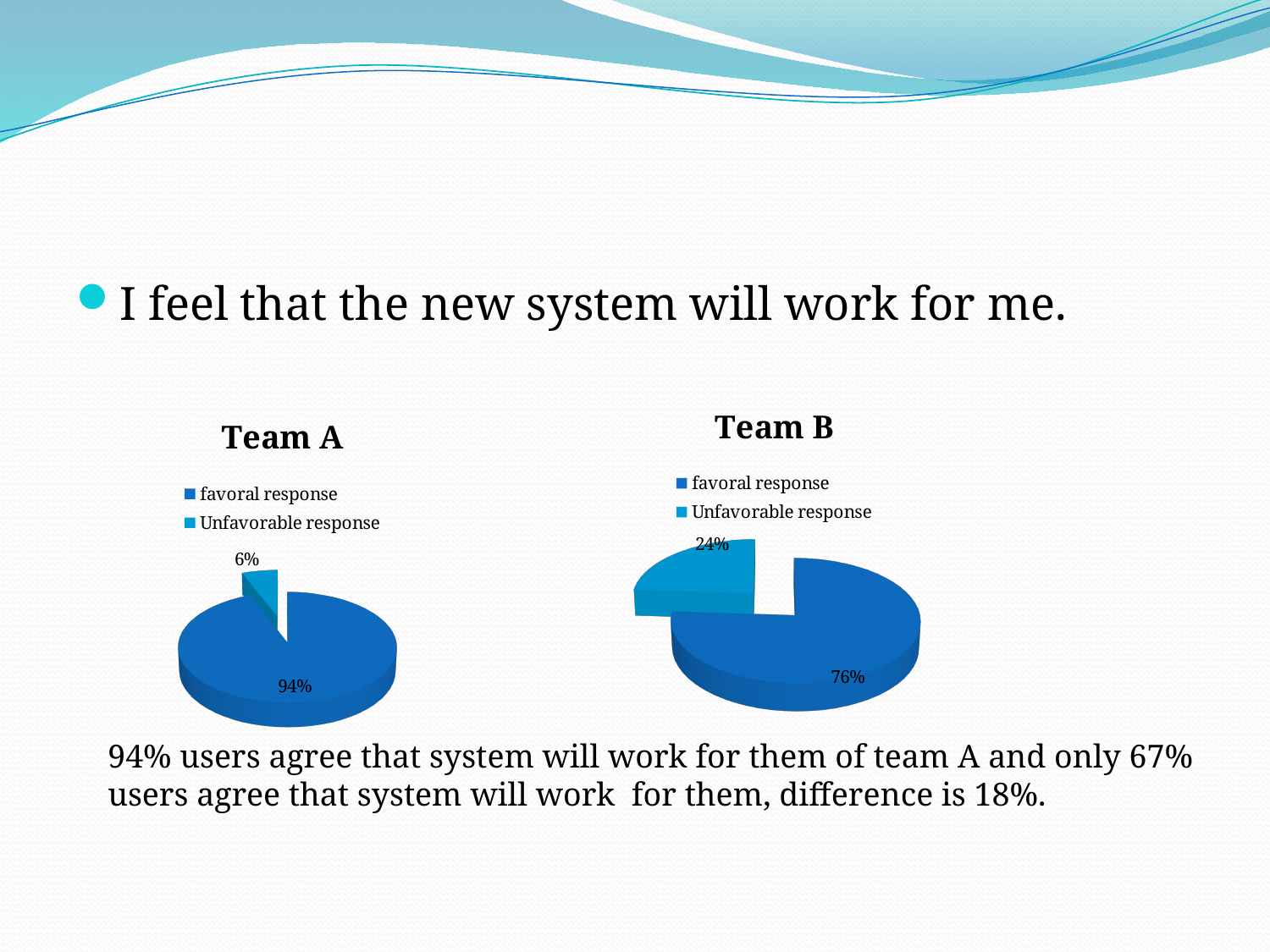
What is the title of the chart on the right side of the slide? Team B In the Team A chart, what percentage is the Unfavorable response slice? 6% How many entries does the legend of the Team A chart list? 2 In the Team B chart, which slice is the largest? favoral response What is the difference between the favoral response share in the Team A chart and the favoral response share in the Team B chart? 18% In the Team B chart, what percentage is the favoral response slice? 76% How many slices does the Team B chart have? 2 Which chart has the larger Unfavorable response slice, Team A or Team B? Team B What kind of chart is the Team A chart? Pie chart In the Team A chart, what percentage is the favoral response slice? 94% In the Team B chart, what percentage is the Unfavorable response slice? 24% In the Team A chart, which slice is the smallest? Unfavorable response